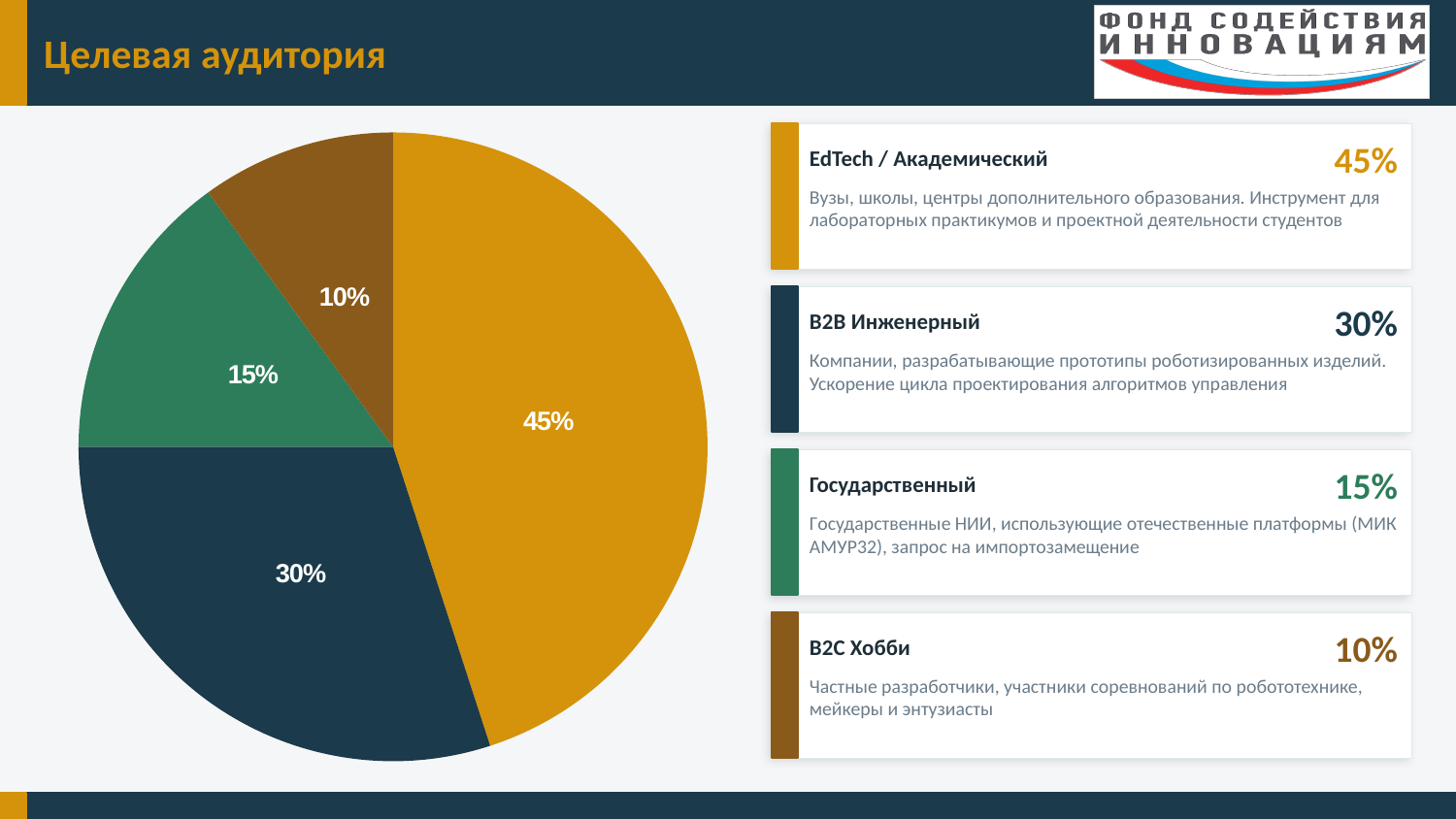
What share of the pie does the EdTech / Академический segment represent? 45% What colour is the slice representing the B2B Инженерный segment? Dark blue How many slices does the pie chart have? 4 What is the difference between the EdTech / Академический and B2B Инженерный shares? 15% What is the value shown for the Государственный segment? 15% What is the value shown for the B2B Инженерный segment? 30% What is the combined share of the Государственный and B2C Хобби segments? 25% Which segment is the largest in the pie chart? EdTech / Академический Which segment is the smallest in the pie chart? B2C Хобби What kind of chart is shown on the slide? Pie chart Which is larger, the Государственный share or the B2C Хобби share? Государственный What is the value shown for the B2C Хобби segment? 10%